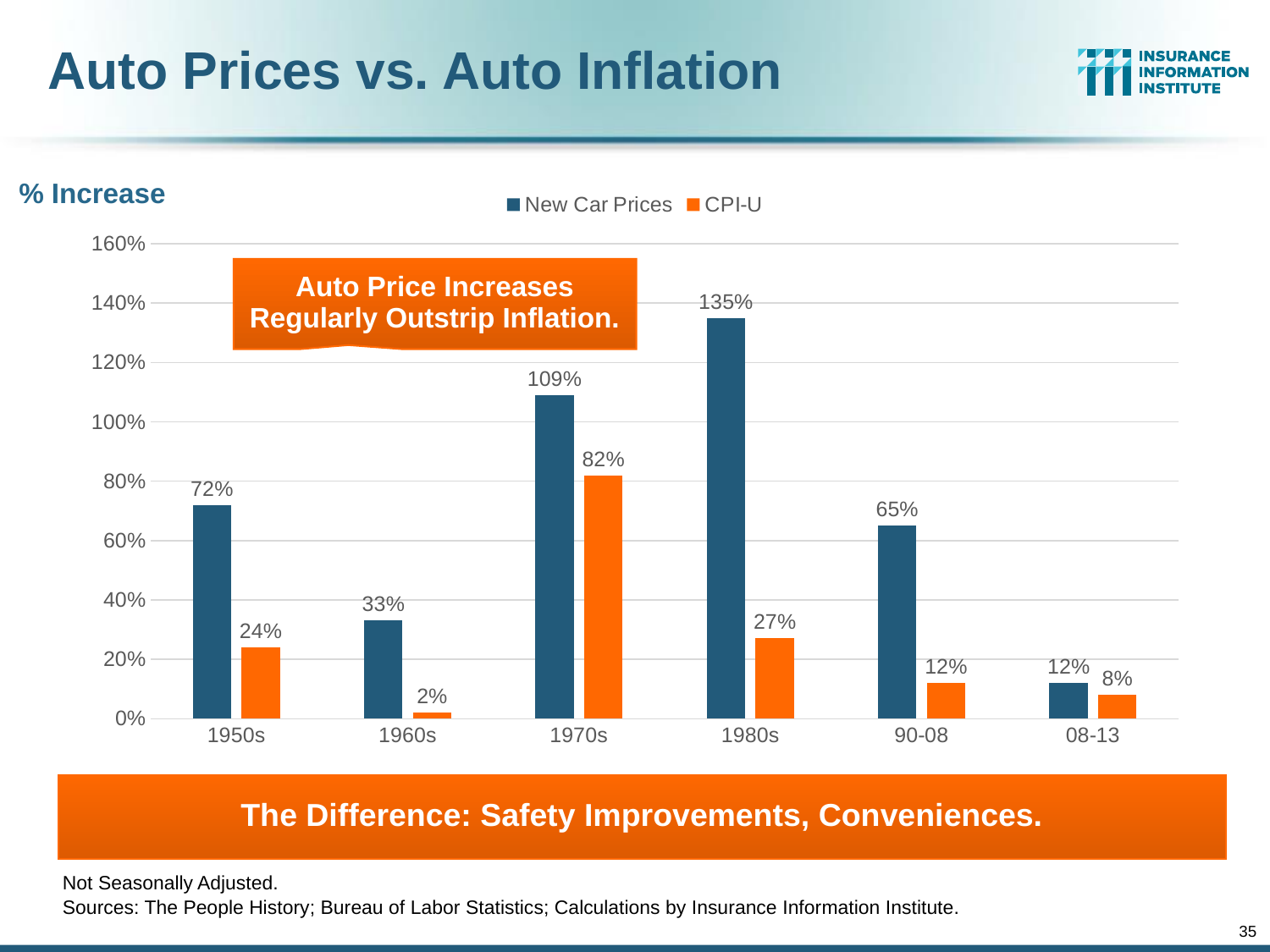
What is the New Car Prices value for the 1970s? 109% Which is larger in the 1950s, New Car Prices or CPI-U? New Car Prices What colour are the CPI-U bars? orange Which period has the lowest CPI-U value? 1960s What kind of chart is shown on the slide? bar chart Is the New Car Prices value for the 1980s greater or less than 120%? greater What is the difference between New Car Prices and CPI-U in the 1980s? 108% How many series does the legend list? 2 How many periods are shown on the x axis? 6 Which period has the highest New Car Prices value? 1980s What is the New Car Prices value for 90-08? 65% What is the CPI-U value for the 1960s? 2%